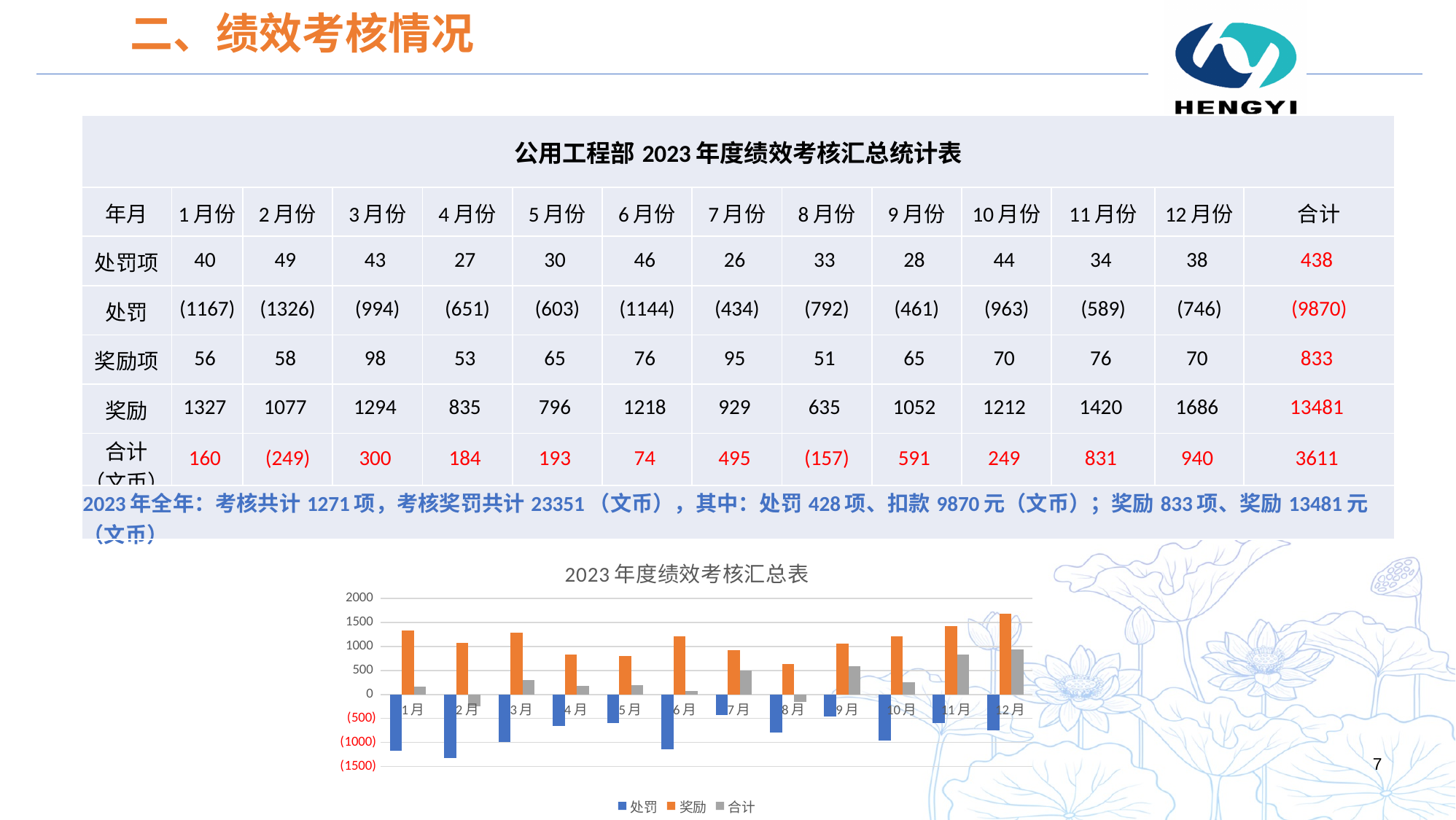
In the chart, do the 奖励 bars rise or fall from 9月 to 12月? rise In the chart, which month has the highest 奖励 bar? 12月 In the chart, which month has the lowest 奖励 bar? 8月 How many series does the legend of the chart list? 3 In the chart, which month has the larger 奖励 bar, 3月 or 4月? 3月 What is the title of the chart? 2023年度绩效考核汇总表 How many months are shown on the x axis of the chart? 12 In the chart, which month has the highest 合计 bar? 12月 What kind of chart is shown at the bottom of the slide? bar chart In the chart, which month has the lowest (most negative) 合计 bar? 2月 In the chart, is the 奖励 value for 1月 greater or less than 1000? greater In the chart, is the 合计 value for 6月 greater or less than 500? less